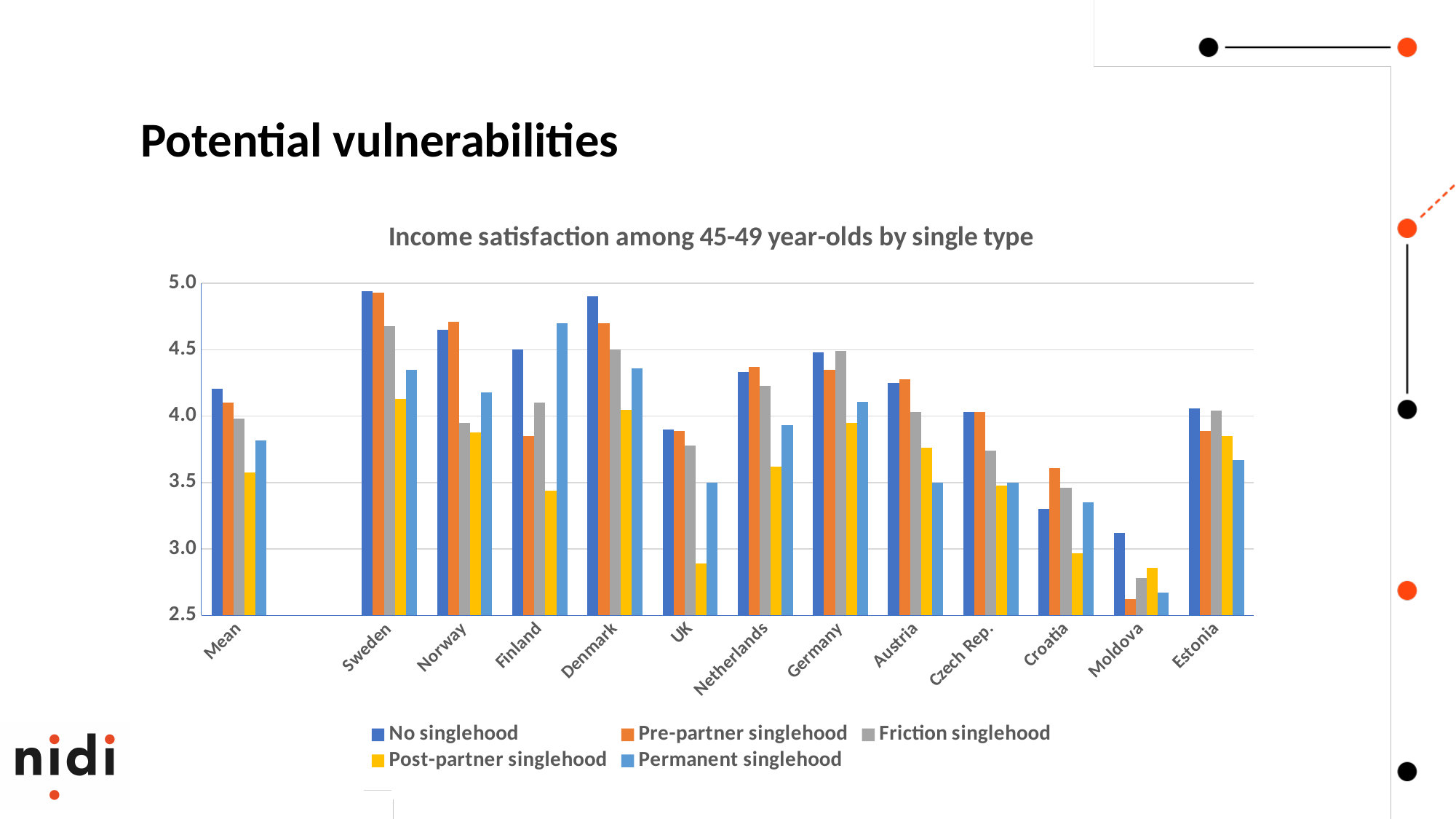
Is the value for Pre-partner singlehood in Moldova greater or less than 3.0? less What is the title of the chart? Income satisfaction among 45-49 year-olds by single type Which series is shown in yellow? Post-partner singlehood Is the value for No singlehood in Croatia greater or less than 3.5? less Which country has the lowest value for Pre-partner singlehood? Moldova Is the value for Permanent singlehood in Finland greater or less than 4.5? greater How many series does the legend list? 5 What kind of chart is shown on the slide? bar chart In Finland, which is larger: Permanent singlehood or Post-partner singlehood? Permanent singlehood How many categories are shown on the x axis? 13 Which country has the highest value for Permanent singlehood? Finland